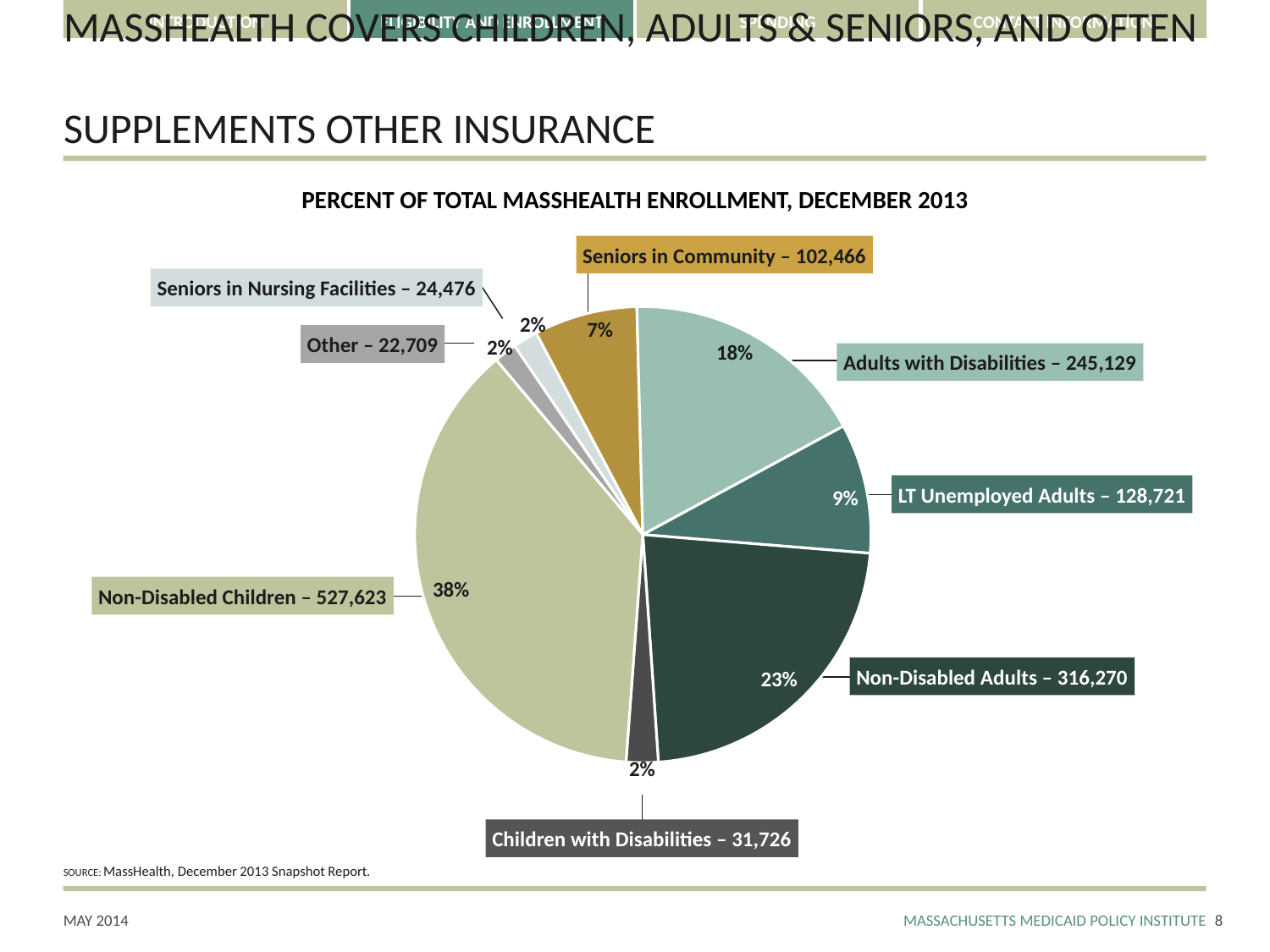
How many categories does the pie chart show? 8 What is the enrollment count for Non-Disabled Adults? 316,270 What kind of chart is shown on the slide? Pie chart Which category has the largest share of enrollment? Non-Disabled Children What share of total MassHealth enrollment is Adults with Disabilities? 18% What is the difference in percentage points between the Non-Disabled Children share and the Non-Disabled Adults share? 15 percentage points What share of total MassHealth enrollment is Non-Disabled Children? 38% Which has a larger share of enrollment, Non-Disabled Adults or Adults with Disabilities? Non-Disabled Adults What share of total MassHealth enrollment is Seniors in Community? 7% What is the enrollment count for LT Unemployed Adults? 128,721 What is the enrollment count for Seniors in Nursing Facilities? 24,476 What is the title of the chart? PERCENT OF TOTAL MASSHEALTH ENROLLMENT, DECEMBER 2013